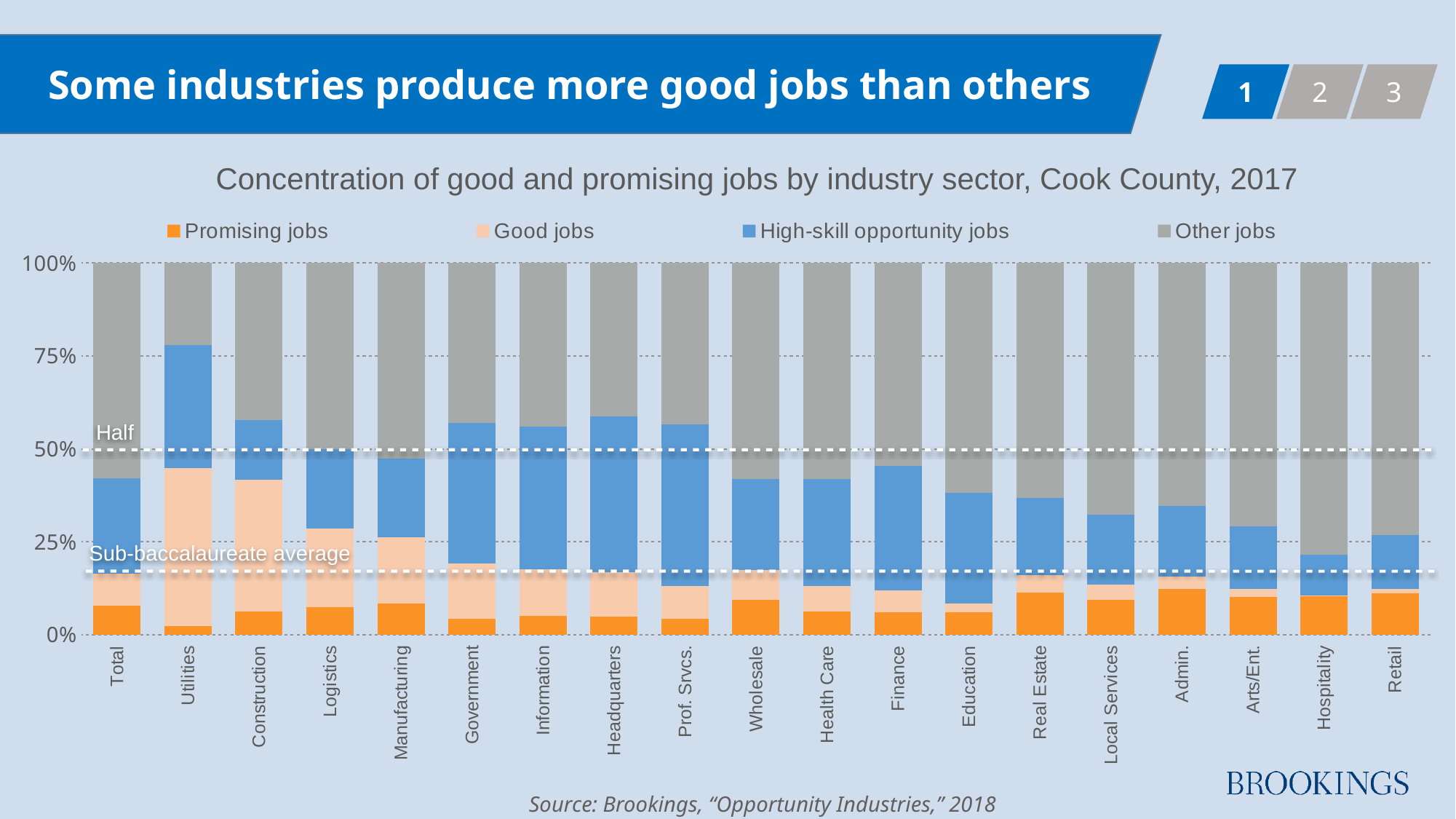
Is the combined share of promising, good and high-skill opportunity jobs for Education greater or less than 50%? less Which industry has the smallest combined share of promising, good and high-skill opportunity jobs (the largest 'Other jobs' share)? Hospitality Is the combined share of promising, good and high-skill opportunity jobs for Utilities greater or less than 75%? greater Which industry has the smallest 'Promising jobs' segment? Utilities Which industry has the largest 'Good jobs' segment? Utilities What kind of chart is shown on the slide? Stacked bar chart What is the title of the chart? Concentration of good and promising jobs by industry sector, Cook County, 2017 Which has a larger 'Other jobs' share, Hospitality or Government? Hospitality How many industry categories are shown along the x axis of the chart? 19 Which industry has the largest combined share of promising, good and high-skill opportunity jobs (the smallest 'Other jobs' share)? Utilities How many series does the chart's legend list? 4 What are the two labelled dashed horizontal reference lines on the chart? Half and Sub-baccalaureate average